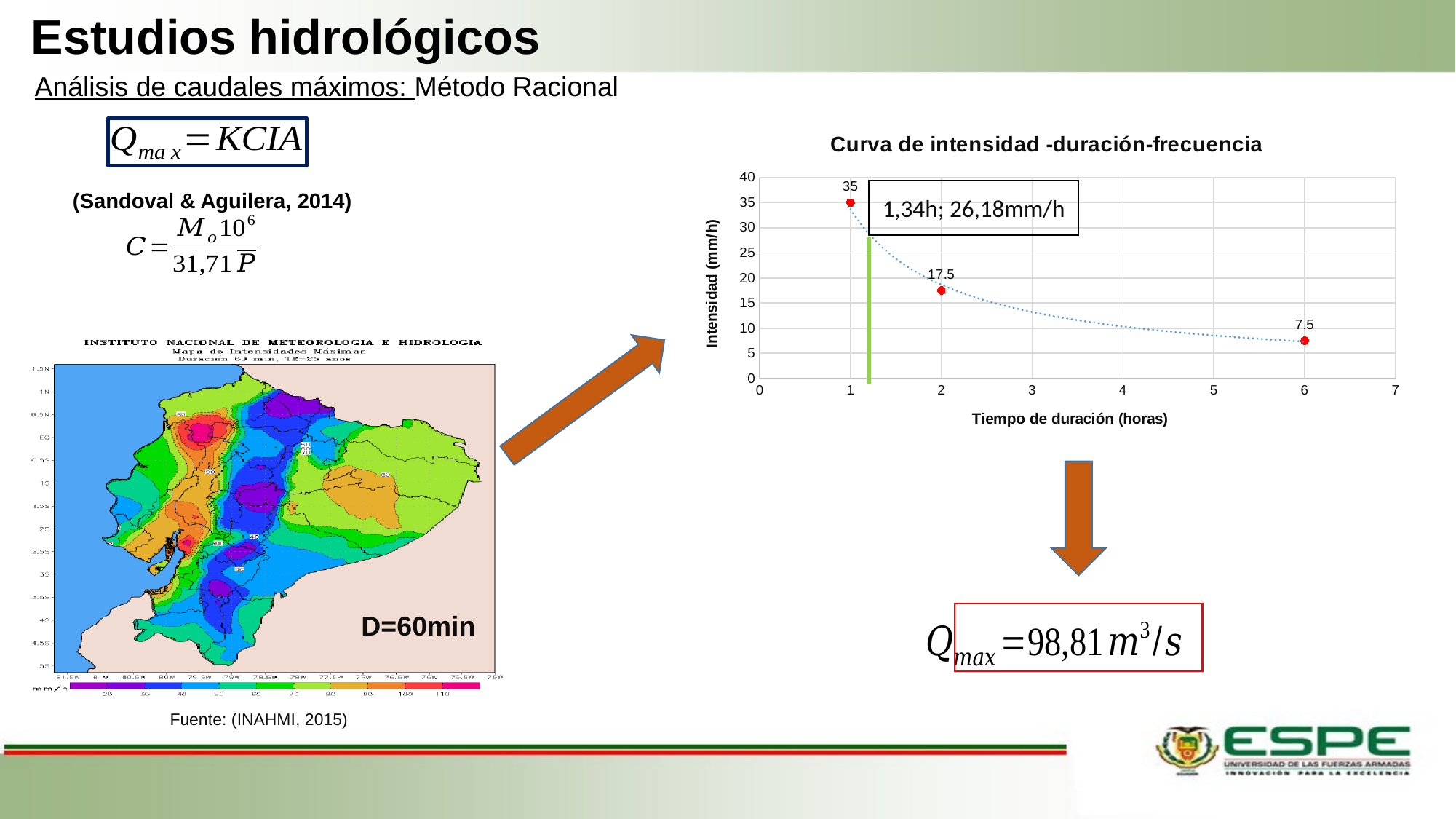
What is the intensity value (mm/h) at a duration of 6 hours? 7.5 What is the title of the chart on the slide? Curva de intensidad -duración-frecuencia Does the intensity rise or fall as the duration increases along the x axis? fall What is the label on the y axis of the chart? Intensidad (mm/h) How many data points are plotted on the chart? 3 What is the intensity value (mm/h) at a duration of 2 hours? 17.5 What is the difference between the intensity at 1 hour and the intensity at 2 hours? 17.5 What type of chart is shown on the slide? scatter chart What is the intensity value (mm/h) at a duration of 1 hour? 35 At which duration (hours) is the intensity highest? 1 Which has a higher intensity: the point at 2 hours or the point at 6 hours? 2 hours At which duration (hours) is the intensity lowest? 6